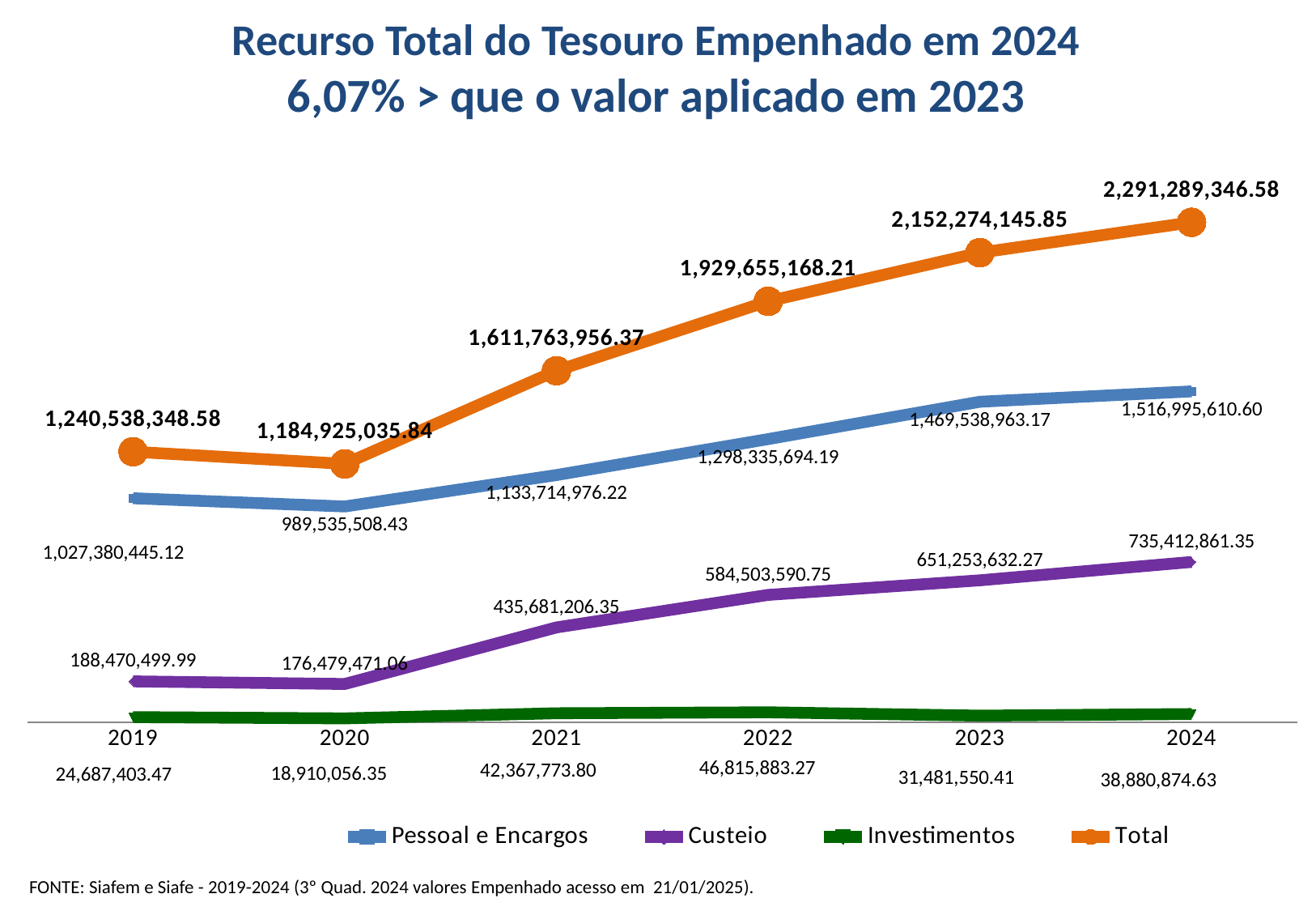
What is the value of Custeio in 2022? 584,503,590.75 What is the value of Investimentos in 2020? 18,910,056.35 What is the value of the Total series in 2024? 2,291,289,346.58 How many series does the legend list? 4 Which is larger: Pessoal e Encargos in 2019 or Pessoal e Encargos in 2020? 2019 What is the difference between the Total value in 2024 and in 2023? 139,015,200.73 What kind of chart is shown on the slide? Line chart How many years are shown on the x axis? 6 What is the value of Pessoal e Encargos in 2021? 1,133,714,976.22 What is the difference between the Custeio value in 2024 and in 2019? 546,942,361.36 In which year is the Total series lowest? 2020 In which year is the Investimentos series highest? 2022